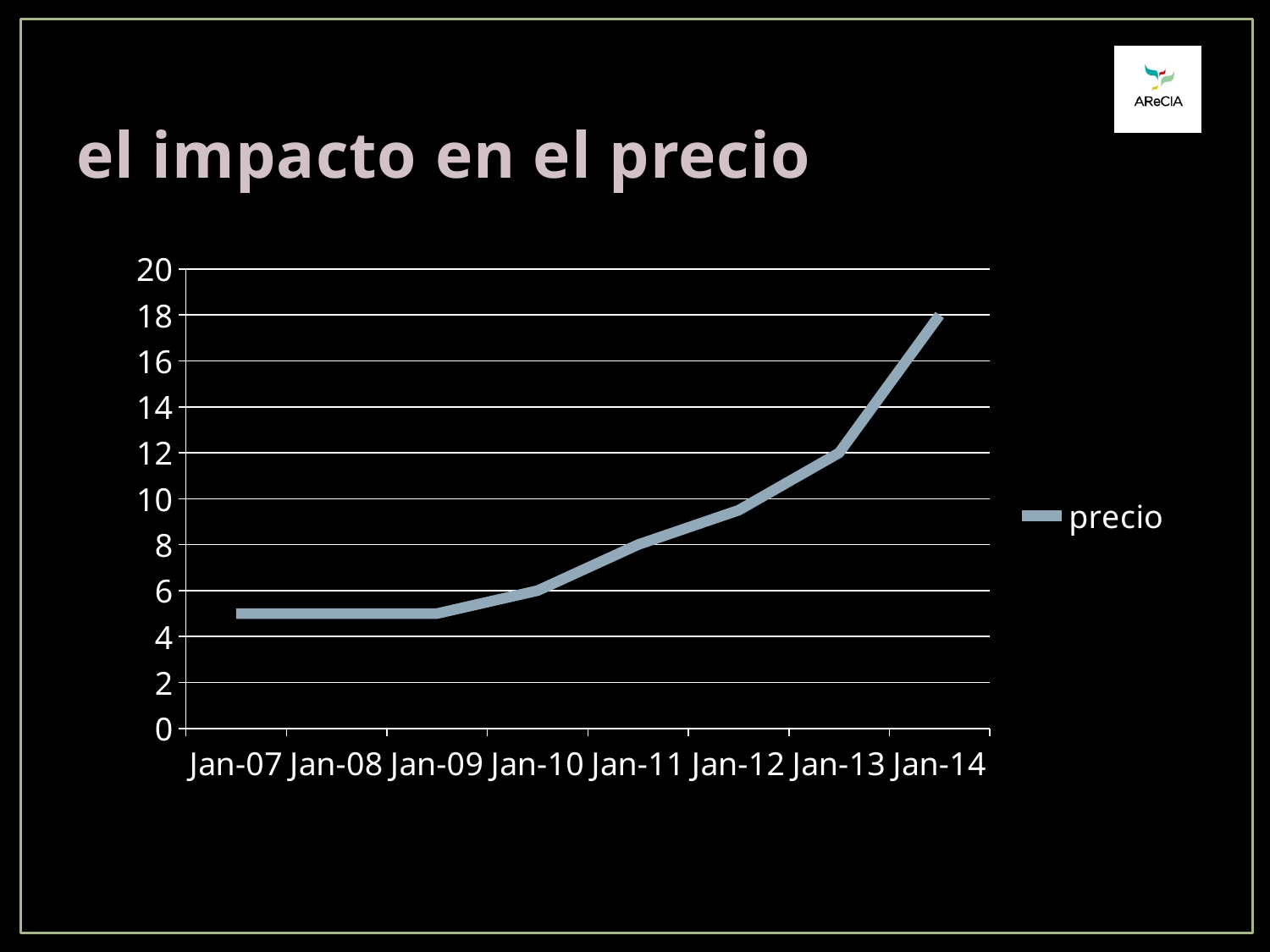
Is the value for precio at Jan-12 greater or less than 8? greater Which is larger, the value for precio at Jan-13 or at Jan-11? Jan-13 Which date has the highest value for precio? Jan-14 What kind of chart is shown on the slide? line chart Is the value for precio at Jan-07 greater or less than 6? less What is the name of the series shown in the legend? precio What is the difference between the precio values at Jan-14 and Jan-13? 6 How many series does the legend list? 1 Do the values for precio rise or fall from Jan-07 to Jan-14? rise What is the value for precio at Jan-14? 18 How many points are plotted along the x axis? 8 What is the value for precio at Jan-13? 12